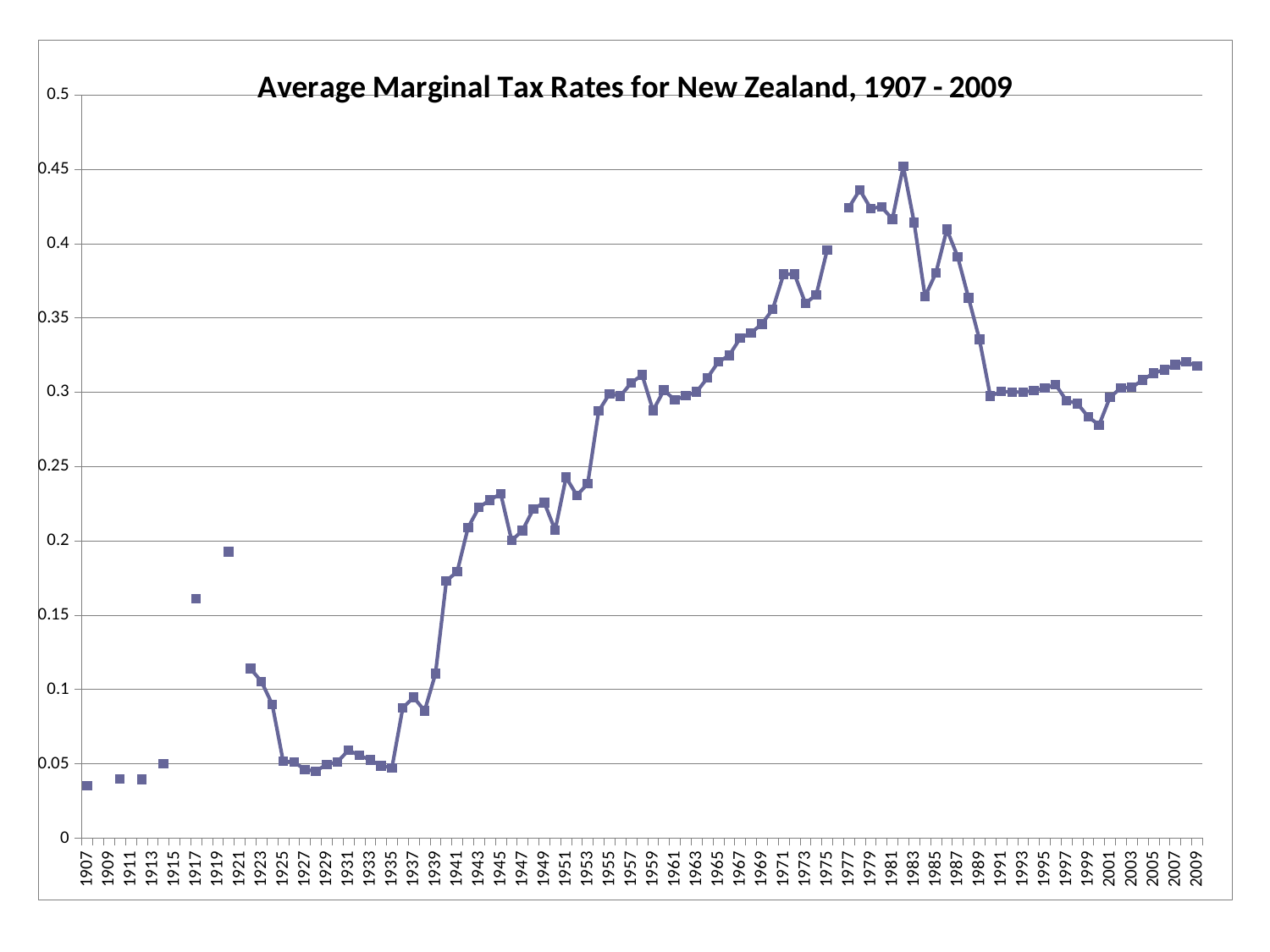
Which year has the highest average marginal tax rate? 1982 Is the value for 1982 greater or less than 0.4? greater Do the values rise or fall between 1983 and 1990? fall Is the value for 1927 greater or less than 0.1? less Is the value for 1941 greater or less than 0.15? greater What kind of chart is shown on the slide? line chart What is the title of the chart? Average Marginal Tax Rates for New Zealand, 1907 - 2009 Which year has the lowest average marginal tax rate? 1907 Which is larger, the value for 1975 or the value for 1991? 1975